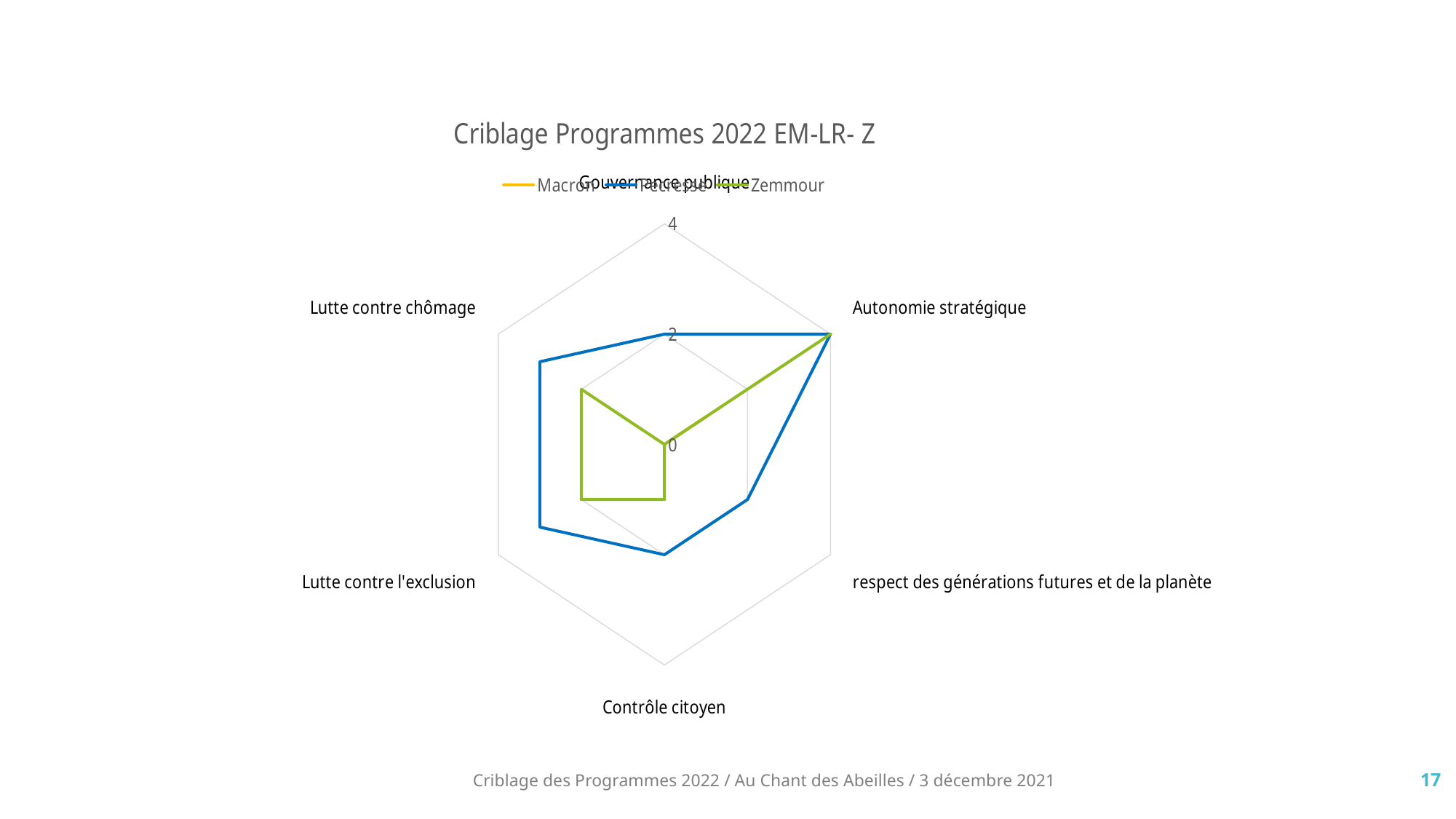
What is the value for Pécresse on Autonomie stratégique? 4 How many categories (axes) does the radar chart have? 6 What kind of chart is shown on the slide? Radar chart Is the value for Zemmour on Contrôle citoyen greater or less than 2? less How many series does the legend list? 3 On Lutte contre l'exclusion, which series has the larger value, Pécresse or Zemmour? Pécresse What is the value for Pécresse on Contrôle citoyen? 2 On which category does Pécresse reach her highest value? Autonomie stratégique What is the value for Zemmour on Gouvernance publique? 0 What is the title of the chart? Criblage Programmes 2022 EM-LR- Z Is the value for Pécresse on Lutte contre chômage greater or less than 2? greater What is the difference between Pécresse and Zemmour on respect des générations futures et de la planète? 2